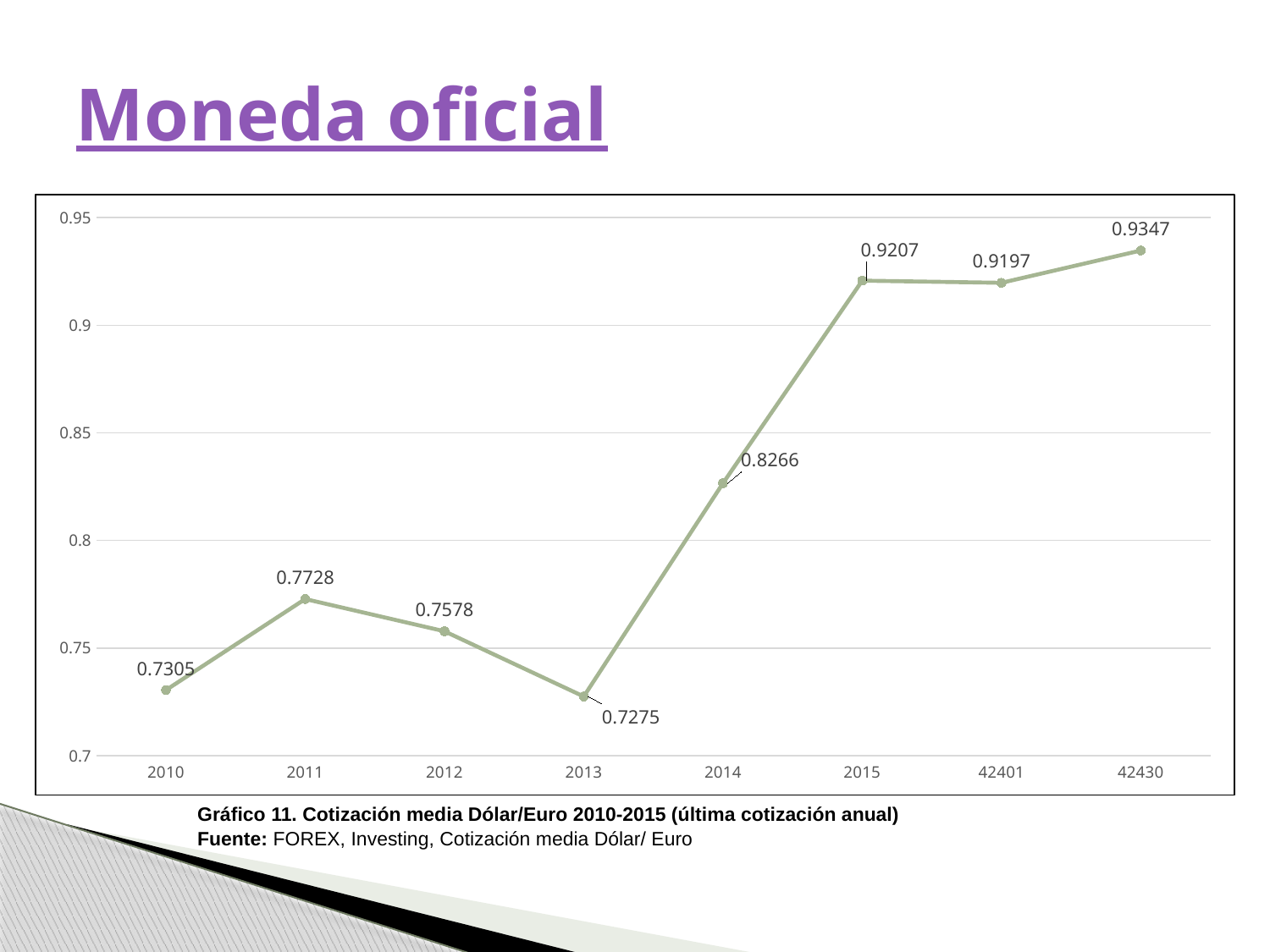
Which is larger, the value for 2011 or the value for 2012? 2011 How many data points are plotted on the chart? 8 What is the caption title given for the chart below it? Gráfico 11. Cotización media Dólar/Euro 2010-2015 (última cotización anual) Which category has the highest value? 42430 What is the difference between the values for 2015 and 2014? 0.0941 What is the value for the category labelled 42430? 0.9347 Which category has the lowest value? 2013 Is the value for 2014 greater or less than 0.8? greater What is the value for 2014? 0.8266 Does the value rise or fall from 2012 to 2013? fall What is the value for 2010? 0.7305 What kind of chart is shown on the slide? line chart